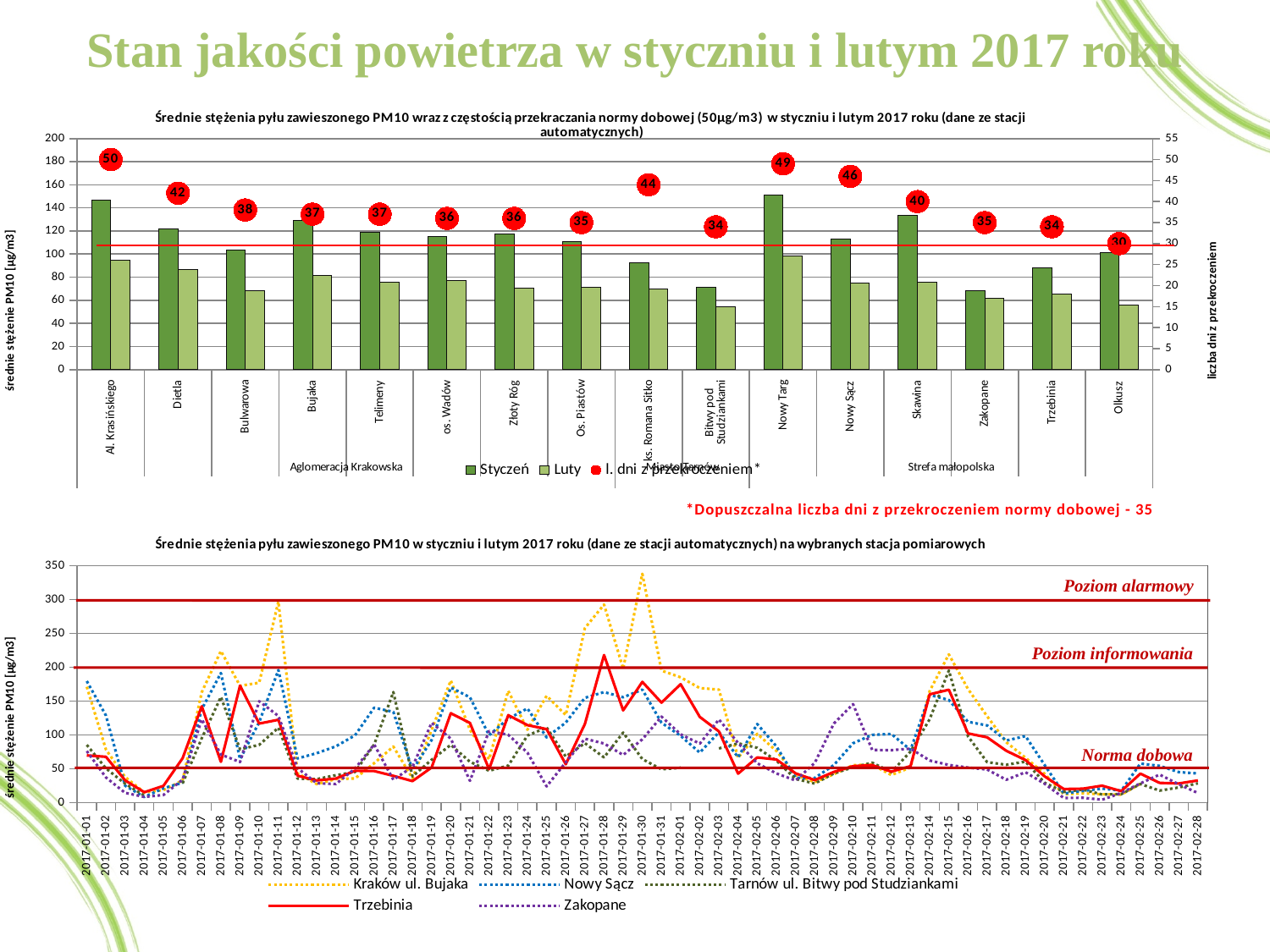
What kind of chart is the top chart? combination bar and line chart (bars with red circle markers) How many series does the legend of the top chart list? 3 In the top chart, is the Styczeń value for Al. Krasińskiego greater or less than 140? greater In the top chart, how many days with exceedance are shown for Nowy Targ? 49 In the top chart, what is the difference in days with exceedance between Nowy Targ and Nowy Sącz? 3 In the top chart, which station has more days with exceedance, Dietla or Skawina? Dietla In the top chart, is the Luty value for Al. Krasińskiego greater or less than 100? less In the top chart, how many days with exceedance (l. dni z przekroczeniem) are shown for Al. Krasińskiego? 50 How many series does the legend of the bottom chart list? 5 In the top chart, which station has the highest number of days with exceedance? Al. Krasińskiego How many stations are shown on the x axis of the top chart? 16 In the bottom chart, at what value is the Poziom alarmowy line drawn? 300